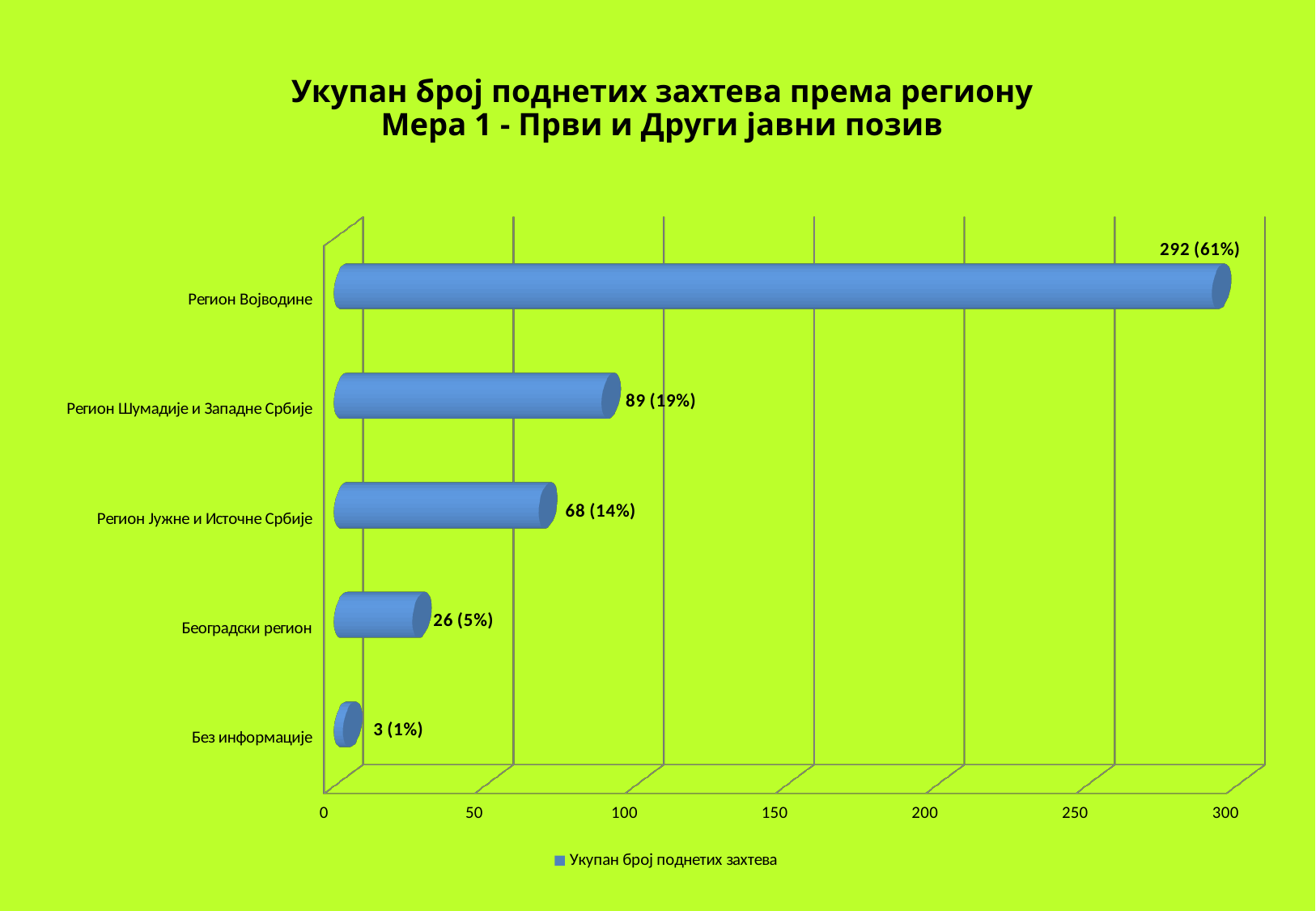
What is the value for Регион Шумадије и Западне Србије? 89 (19%) Which region has the highest number of submitted requests? Регион Војводине How many categories are shown in the chart? 5 Is the value for Регион Војводине greater or less than 250? greater Which is larger, the value for Регион Јужне и Источне Србије or Београдски регион? Регион Јужне и Источне Србије What is the value for Београдски регион? 26 (5%) What is the difference between the values for Регион Шумадије и Западне Србије and Регион Јужне и Источне Србије? 21 Which category has the lowest value? Без информације What is the legend entry of the chart? Укупан број поднетих захтева How many series does the legend list? 1 What kind of chart is shown on the slide? bar chart What is the value for Регион Војводине? 292 (61%)